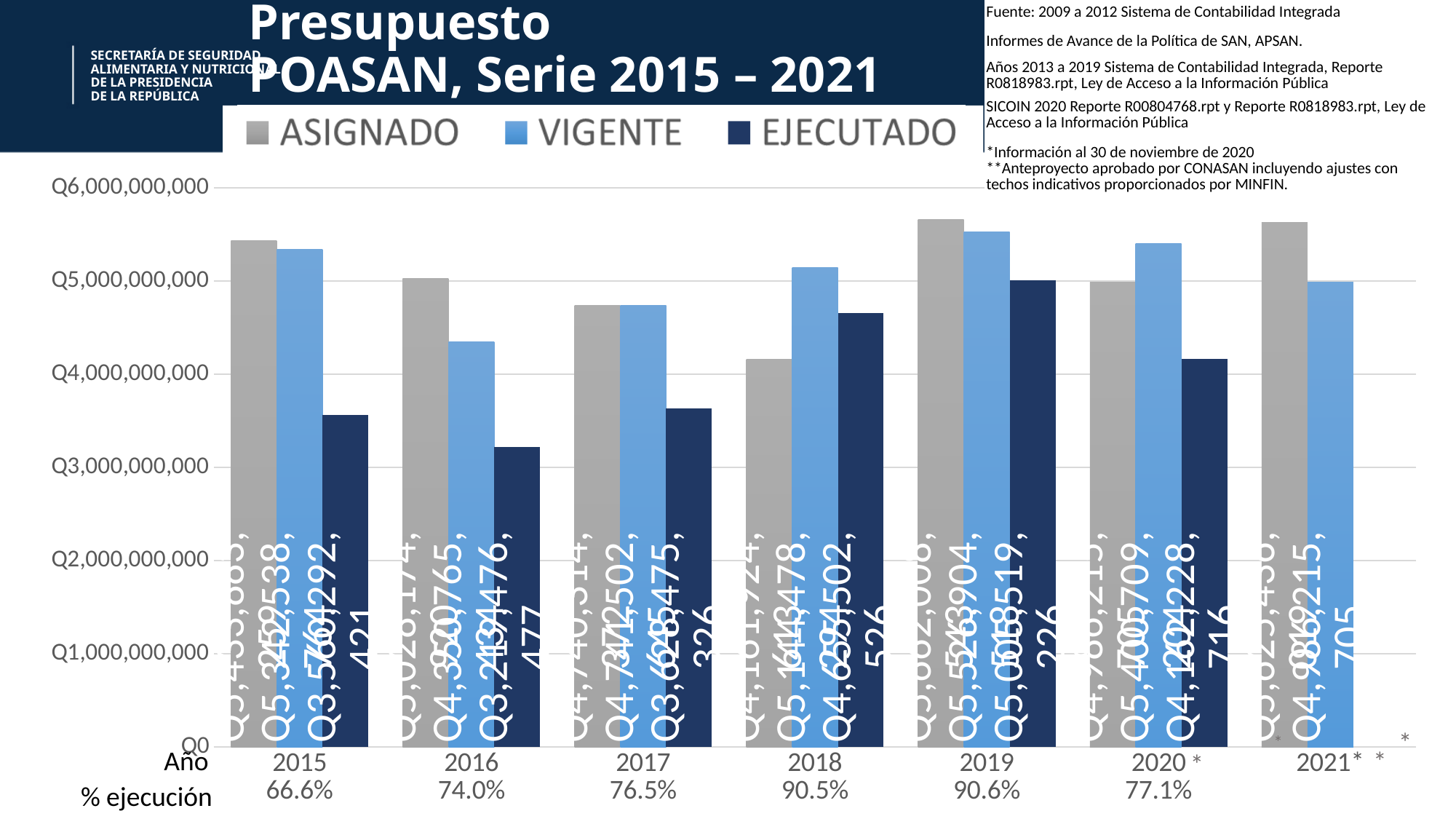
Which year has the lowest % ejecución? 2015 How many series does the legend list? 3 What is the % ejecución shown for 2018? 90.5% What kind of chart is shown on the slide? bar chart Which is larger, the % ejecución for 2016 or for 2020? 2020 (77.1%) Which year has the highest % ejecución? 2019 In which year is the EJECUTADO bar the lowest? 2016 What is the difference between the % ejecución for 2019 and for 2015? 24.0 percentage points What is the % ejecución shown for 2015? 66.6% Is the EJECUTADO value for 2015 greater or less than Q4,000,000,000? less How many years are shown along the x axis? 7 Which year has no EJECUTADO bar? 2021